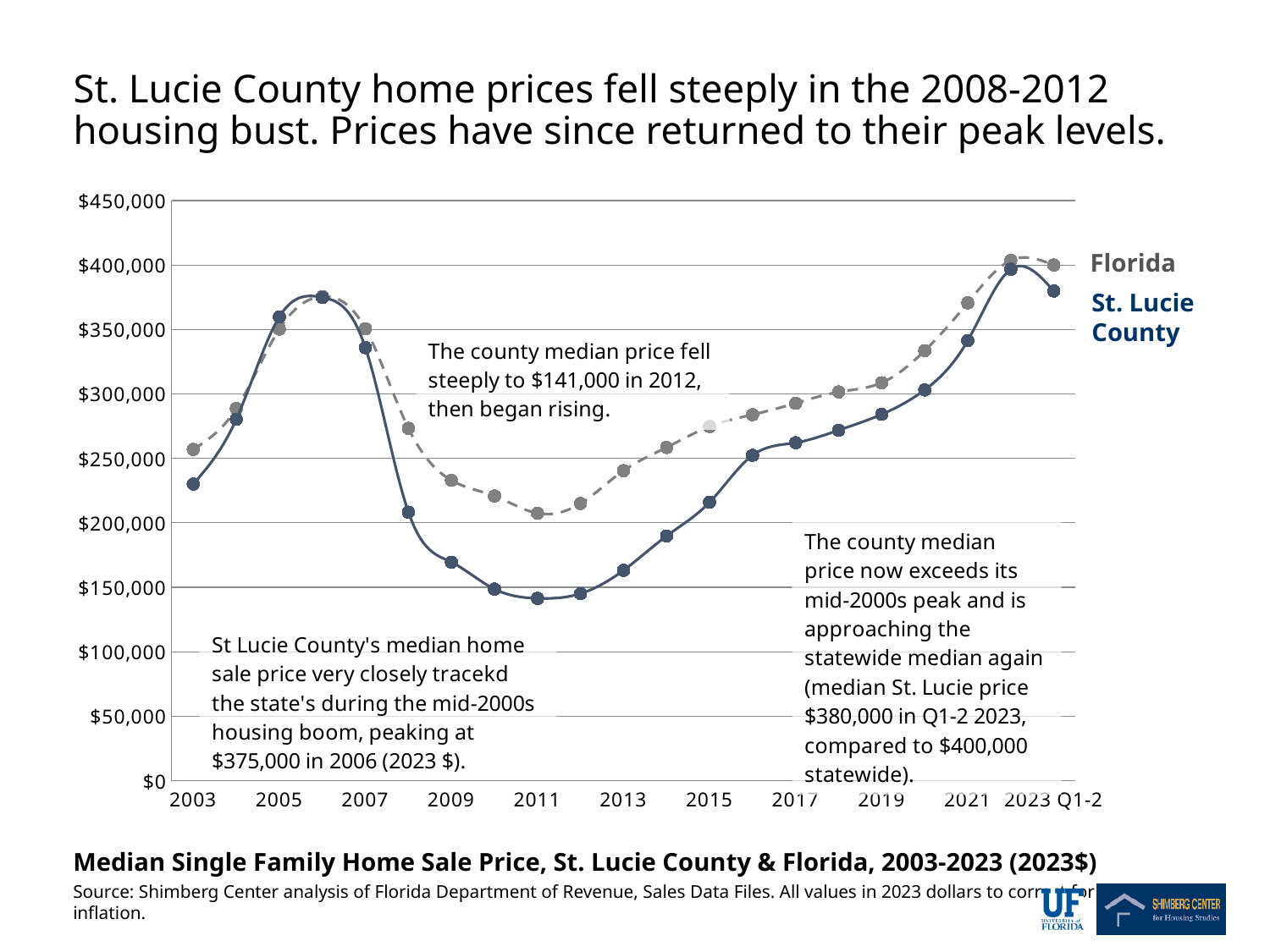
What was the St. Lucie County median home sale price at its 2006 peak? $375,000 What was the statewide (Florida) median home sale price in Q1-2 2023? $400,000 What is the difference between the Florida and St. Lucie County median prices in Q1-2 2023? $20,000 Is the St. Lucie County value for 2009 greater or less than $200,000? less Does the St. Lucie County line rise or fall between 2006 and 2012? fall What was the median St. Lucie County home sale price in Q1-2 2023? $380,000 Is the Florida value for 2021 greater or less than $350,000? greater How many series does the chart show? 2 In Q1-2 2023, which is higher: the Florida median price or the St. Lucie County median price? Florida What was the St. Lucie County median home sale price in 2012? $141,000 What kind of chart is shown on the slide? line chart